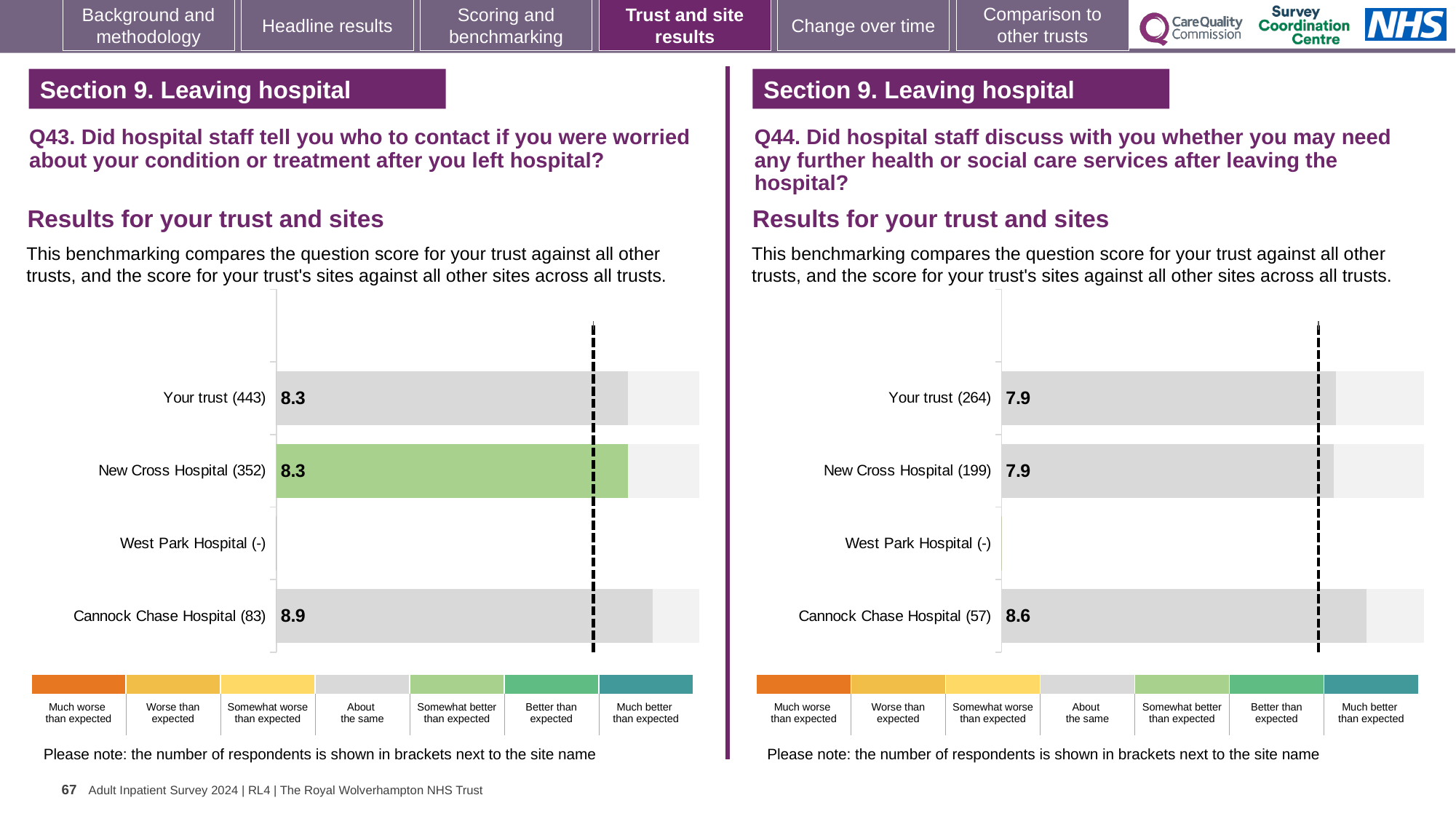
In the Q43 chart on the left, how many respondents are shown in brackets for New Cross Hospital? 352 How many site rows (including Your trust) are listed in the Q44 chart on the right? 4 In the Q44 chart on the right, which site has the highest score? Cannock Chase Hospital In the Q43 chart on the left, what is the score for Your trust? 8.3 What type of chart is used in the Q43 chart on the left? Bar chart In the Q44 chart on the right, what is the score for Cannock Chase Hospital? 8.6 In the Q44 chart on the right, what is the score for New Cross Hospital? 7.9 In the Q43 chart on the left, which site has the highest score? Cannock Chase Hospital In the Q43 chart on the left, what is the score for Cannock Chase Hospital? 8.9 In the Q43 chart on the left, which has the larger score, Cannock Chase Hospital or Your trust? Cannock Chase Hospital In the Q43 chart on the left, what is the difference between the scores for Cannock Chase Hospital and New Cross Hospital? 0.6 In the Q44 chart on the right, what is the difference between the scores for Cannock Chase Hospital and Your trust? 0.7